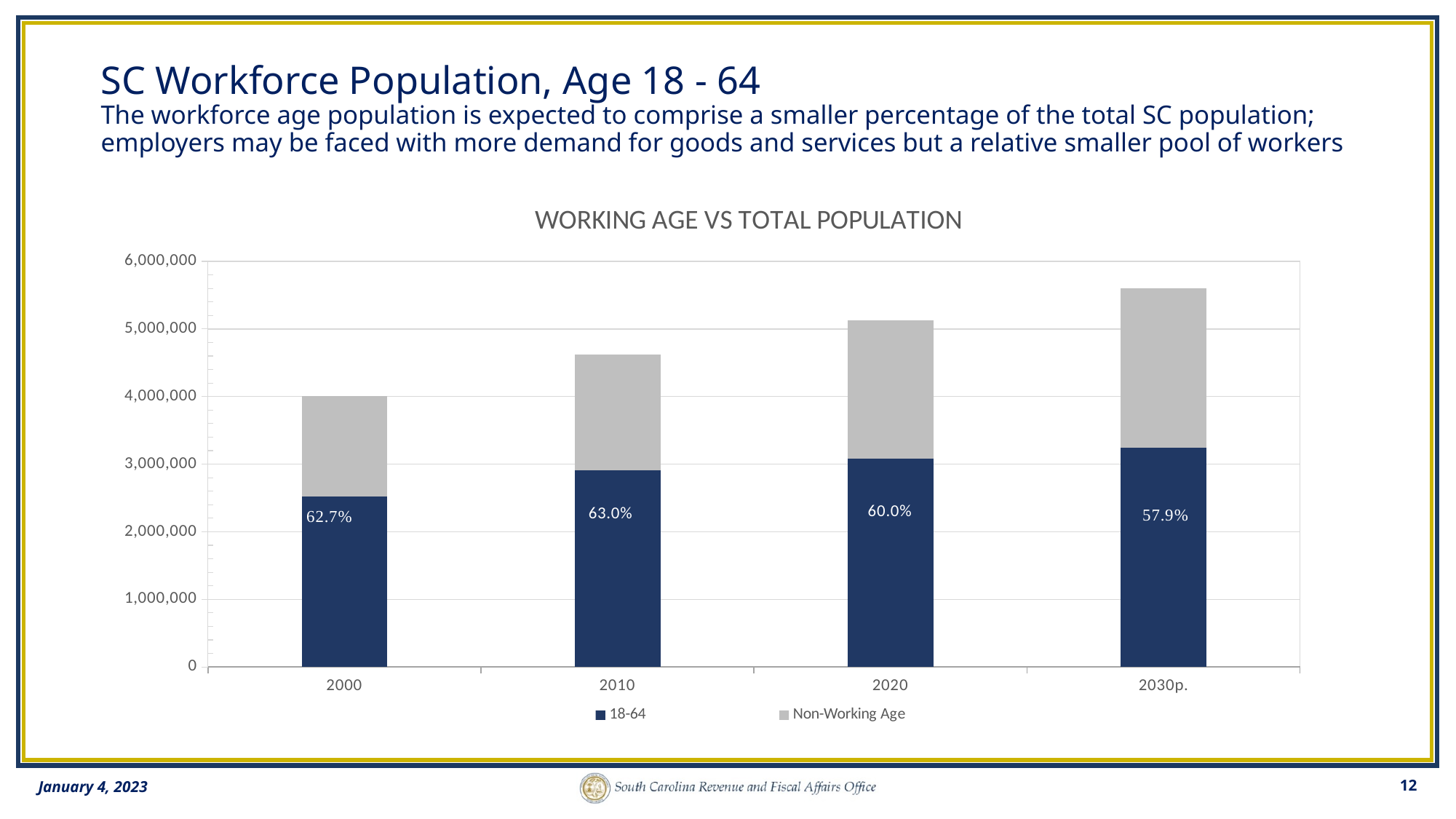
Is the total height of the 2030p. bar greater or less than 5,000,000? greater What percentage label is shown on the 18-64 segment for 2000? 62.7% Is the 18-64 segment for 2000 greater or less than 3,000,000? less Do the total bar heights rise or fall from 2000 to 2030p.? Rise What is the difference in percentage points between the 18-64 labels for 2000 and 2030p.? 4.8 How many series does the legend list? 2 How many years are shown on the x axis? 4 Which year has the highest percentage label on its 18-64 segment? 2010 What kind of chart is shown? Stacked bar chart Which year has the lowest percentage label on its 18-64 segment? 2030p. Which has a larger 18-64 percentage label, 2020 or 2010? 2010 What percentage label is shown on the 18-64 segment for 2030p.? 57.9%